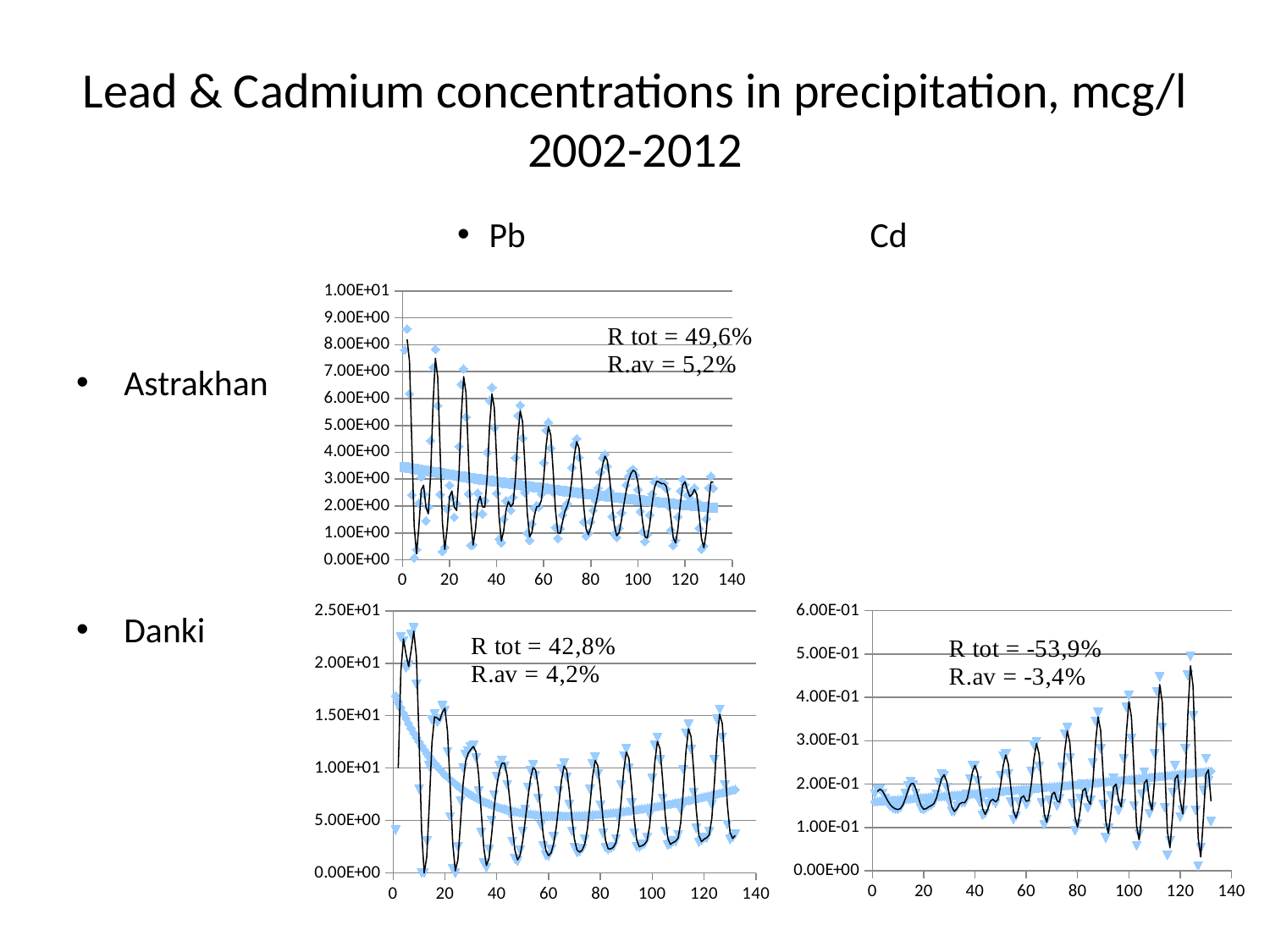
On the Astrakhan Pb chart, is the highest plotted point near x = 0 greater or less than 8.00E+00? greater What kind of chart is the Astrakhan Pb chart? line chart On the Danki Cd chart, what is the R tot value printed on the chart? -53,9% On the Danki Pb chart, what is the R tot value printed on the chart? 42,8% What is the top value shown on the y axis of the Danki Pb chart? 2.50E+01 On the Danki Cd chart, does the thick light-blue trend line rise or fall along the x axis? rise On the Astrakhan Pb chart, what is the R.av value printed on the chart? 5,2% How many charts are shown on the slide? 3 On the Danki Cd chart, what is the R.av value printed on the chart? -3,4% On the Astrakhan Pb chart, does the thick light-blue trend line rise or fall along the x axis? fall On the Astrakhan Pb chart, what is the R tot value printed on the chart? 49,6% On the Danki Pb chart, is the highest plotted point near x = 10 greater or less than 2.00E+01? greater